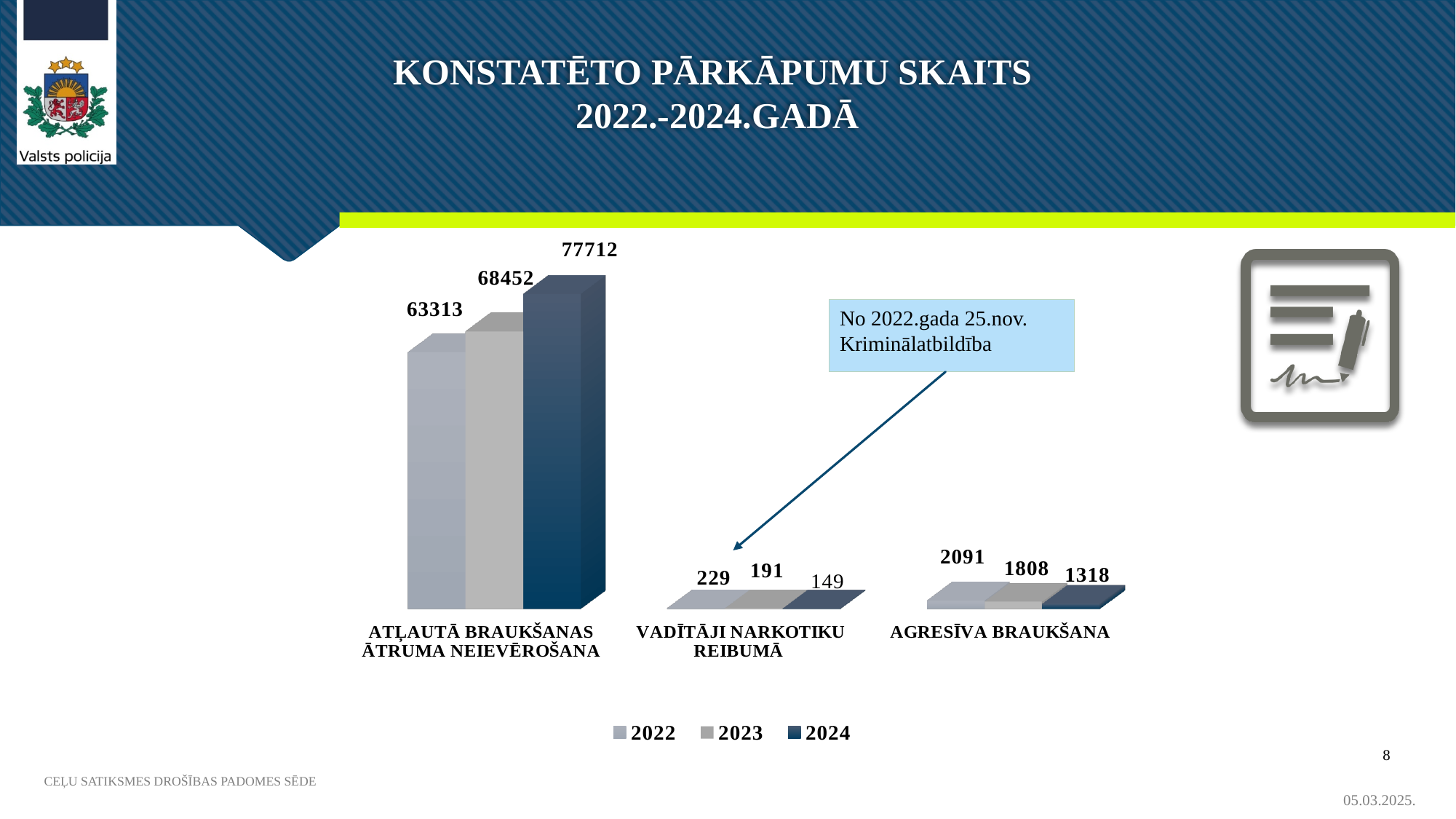
How many categories are shown on the x axis of the chart? 3 Which year has the lowest value in the category AGRESĪVA BRAUKŠANA? 2024 What kind of chart is shown on the slide? Bar chart What is the difference between the 2024 and 2022 values in the category ATĻAUTĀ BRAUKŠANAS ĀTRUMA NEIEVĒROŠANA? 14399 What is the value for 2022 in the category VADĪTĀJI NARKOTIKU REIBUMĀ? 229 What is the value for 2023 in the category AGRESĪVA BRAUKŠANA? 1808 What is the difference between the 2022 and 2024 values in the category VADĪTĀJI NARKOTIKU REIBUMĀ? 80 Which year has the highest value in the category ATĻAUTĀ BRAUKŠANAS ĀTRUMA NEIEVĒROŠANA? 2024 How many series does the legend list? 3 What is the value for 2024 in the category ATĻAUTĀ BRAUKŠANAS ĀTRUMA NEIEVĒROŠANA? 77712 Do the values for AGRESĪVA BRAUKŠANA rise or fall from 2022 to 2024? Fall Which is larger: the 2022 value for AGRESĪVA BRAUKŠANA or the 2022 value for VADĪTĀJI NARKOTIKU REIBUMĀ? AGRESĪVA BRAUKŠANA